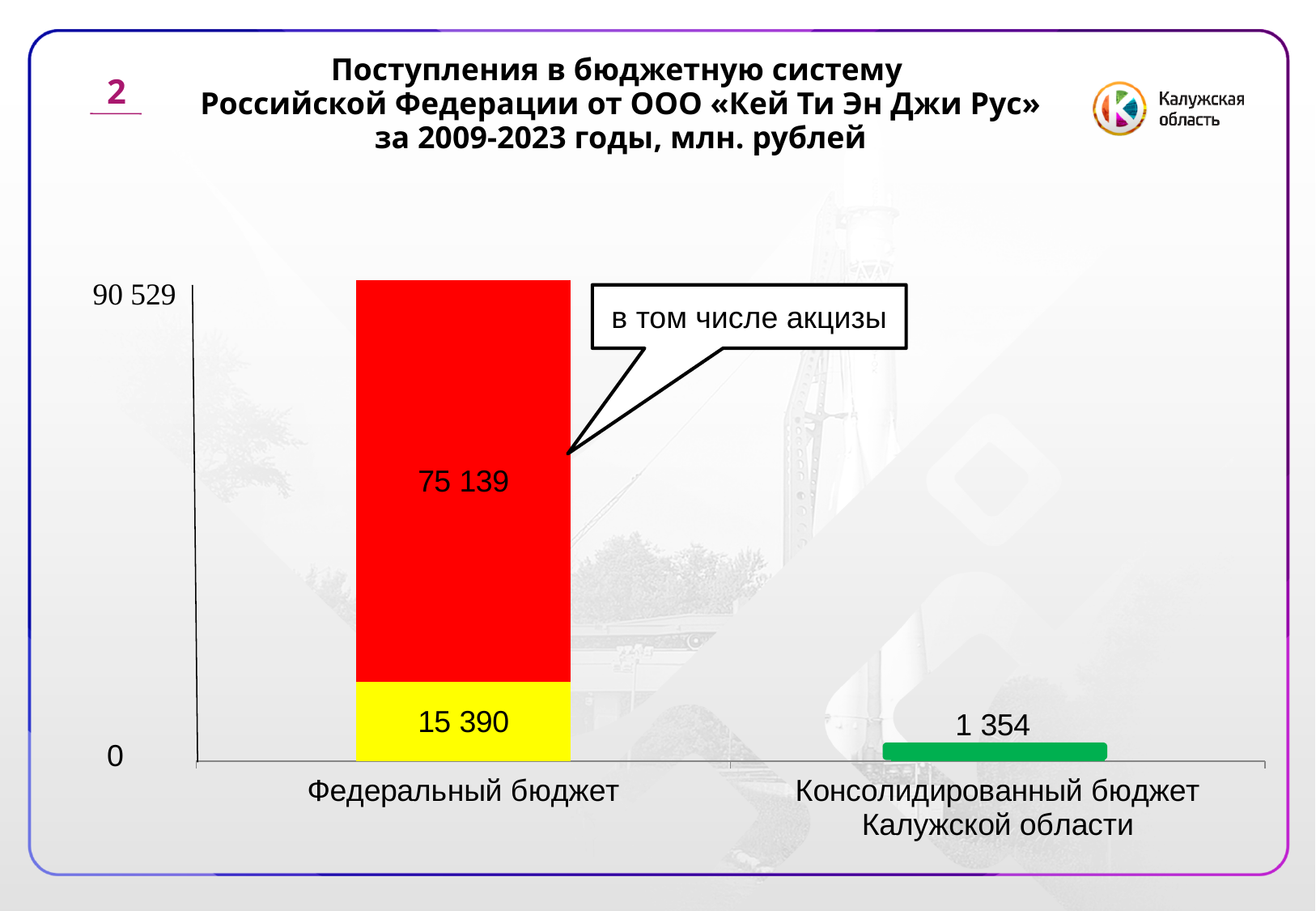
Which is larger: the red segment of Федеральный бюджет or the value for Консолидированный бюджет Калужской области? the red segment of Федеральный бюджет What is the difference between the red segment (75 139) and the yellow segment (15 390) of the Федеральный бюджет bar? 59 749 What kind of chart is shown on the slide? bar chart What is the difference between the yellow segment of Федеральный бюджет (15 390) and the value for Консолидированный бюджет Калужской области (1 354)? 14 036 What is the value for Консолидированный бюджет Калужской области? 1 354 What is the value of the yellow segment in the Федеральный бюджет bar? 15 390 What is the value of the red segment (акцизы) in the Федеральный бюджет bar? 75 139 How many categories are shown on the x axis? 2 Which category has the lowest value? Консолидированный бюджет Калужской области Which category has the highest total value? Федеральный бюджет What is the total of the stacked Федеральный бюджет bar? 90 529 What does the callout pointing to the red segment say? в том числе акцизы